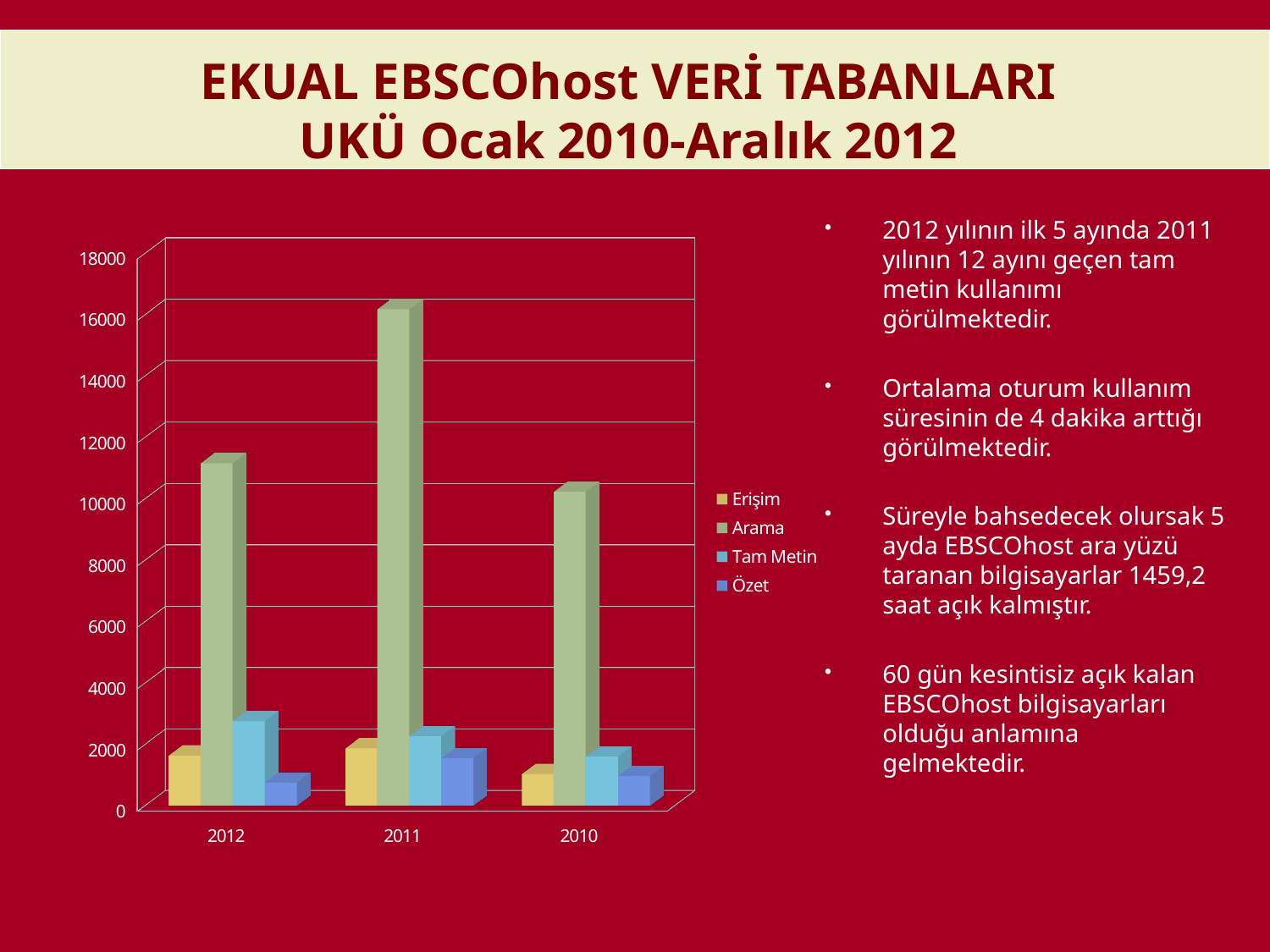
Which series is shown in green in the chart? Arama How many series does the chart legend list? 4 Which year has the highest Arama value? 2011 Is the Arama value for 2012 greater or less than 10000? greater Which is larger, the Özet value for 2011 or the Özet value for 2012? 2011 Is the Tam Metin value for 2012 greater or less than 4000? less What kind of chart is shown on the slide? bar chart Is the Arama value for 2011 greater or less than 14000? greater Which is larger, the Tam Metin value for 2012 or the Tam Metin value for 2010? 2012 What are the four series listed in the chart legend? Erişim, Arama, Tam Metin, Özet Which is larger, the Arama value for 2011 or the Arama value for 2012? 2011 How many year categories are shown on the x axis of the chart? 3